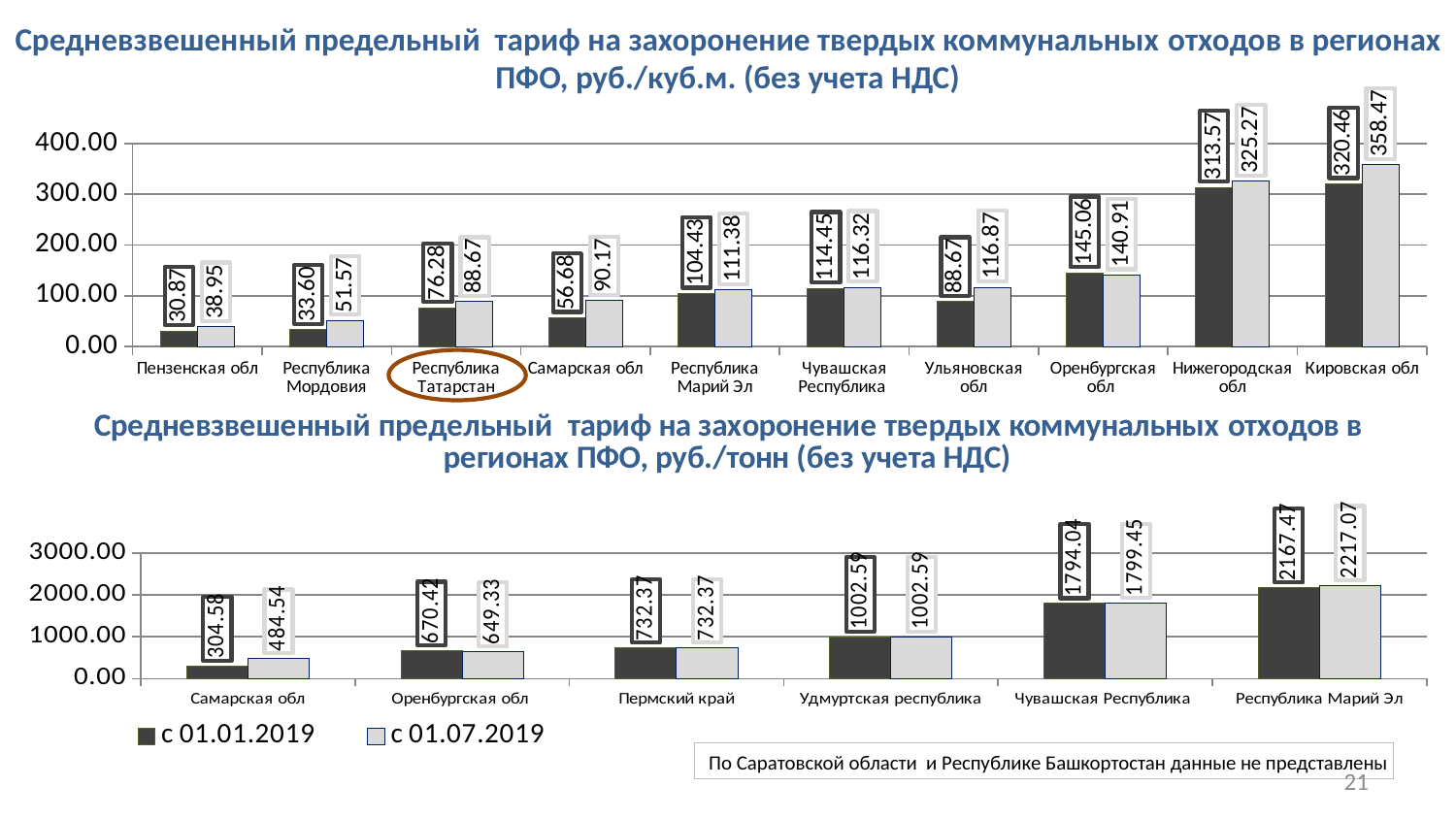
In the bottom chart (руб./тонн), how many series does the legend list? 2 In the bottom chart (руб./тонн), which is larger for Оренбургская обл: с 01.01.2019 or с 01.07.2019? с 01.01.2019 In the top chart (руб./куб.м.), what is the value of the dark bar (с 01.01.2019) for Республика Татарстан? 76.28 In the top chart (руб./куб.м.), which region has the lowest dark bar (с 01.01.2019)? Пензенская обл In the bottom chart (руб./тонн), which region has the highest value in the series с 01.01.2019? Республика Марий Эл In the top chart (руб./куб.м.), which region has the highest light bar (с 01.07.2019)? Кировская обл In the bottom chart (руб./тонн), what is the value for Самарская обл in the series с 01.07.2019? 484.54 In the top chart (руб./куб.м.), how many regions are shown on the x axis? 10 In the top chart (руб./куб.м.), what is the value of the light bar (с 01.07.2019) for Кировская обл? 358.47 What type of chart is the bottom chart (руб./тонн)? Bar chart In the top chart (руб./куб.м.), what is the difference between the light bar (с 01.07.2019) and the dark bar (с 01.01.2019) for Самарская обл? 33.49 In the bottom chart (руб./тонн), what is the difference between с 01.07.2019 and с 01.01.2019 for Республика Марий Эл? 49.60